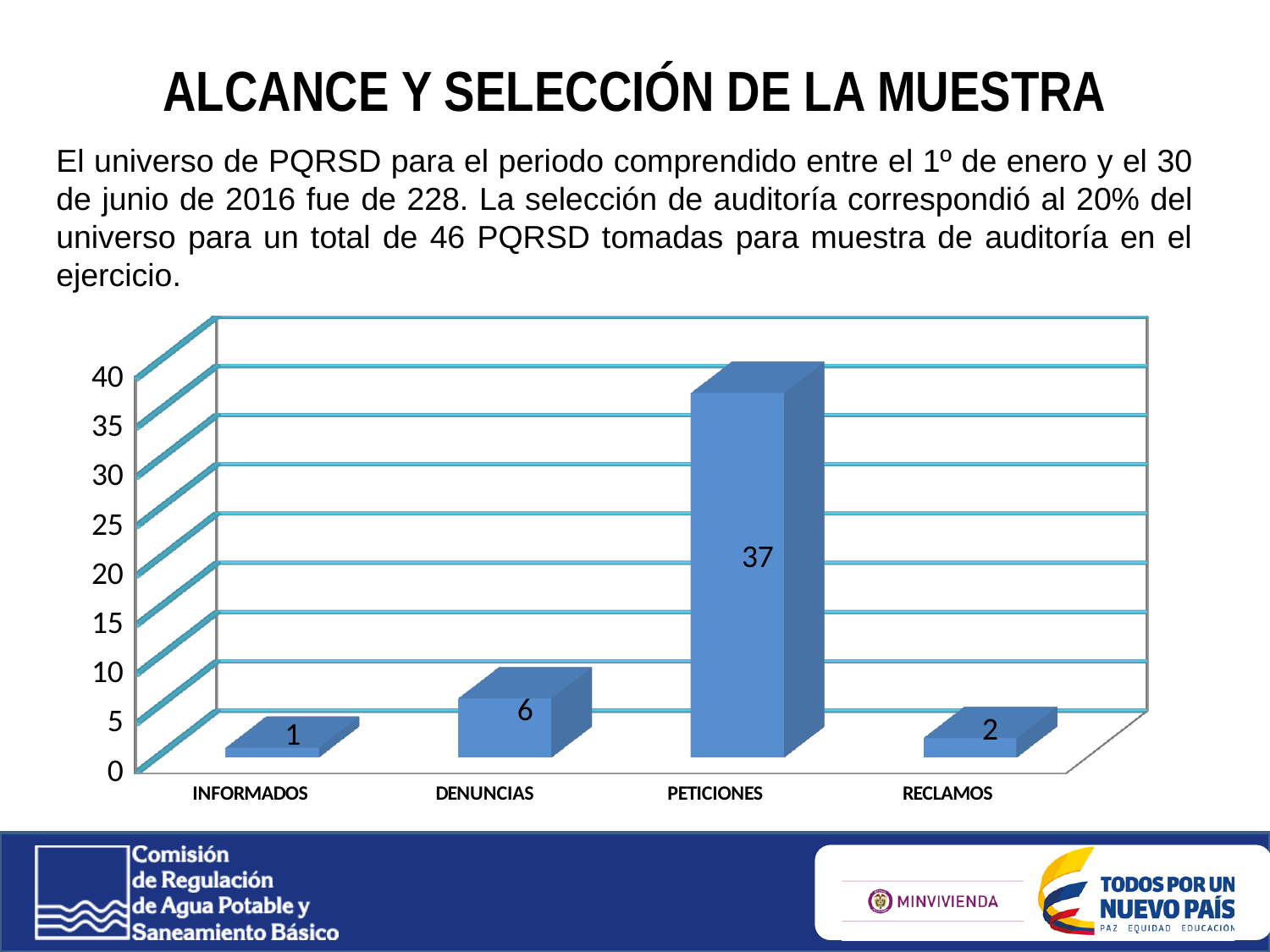
What is the value for PETICIONES? 37 Which category has the highest value? PETICIONES What is the value for DENUNCIAS? 6 What kind of chart is shown on the slide? bar chart What is the value for INFORMADOS? 1 Which is larger, the value for DENUNCIAS or the value for RECLAMOS? DENUNCIAS How many categories are shown on the x axis? 4 Is the value for PETICIONES greater or less than 30? greater What is the total of the four values shown in the chart? 46 What is the difference between the values for PETICIONES and DENUNCIAS? 31 Which category has the lowest value? INFORMADOS What is the value for RECLAMOS? 2